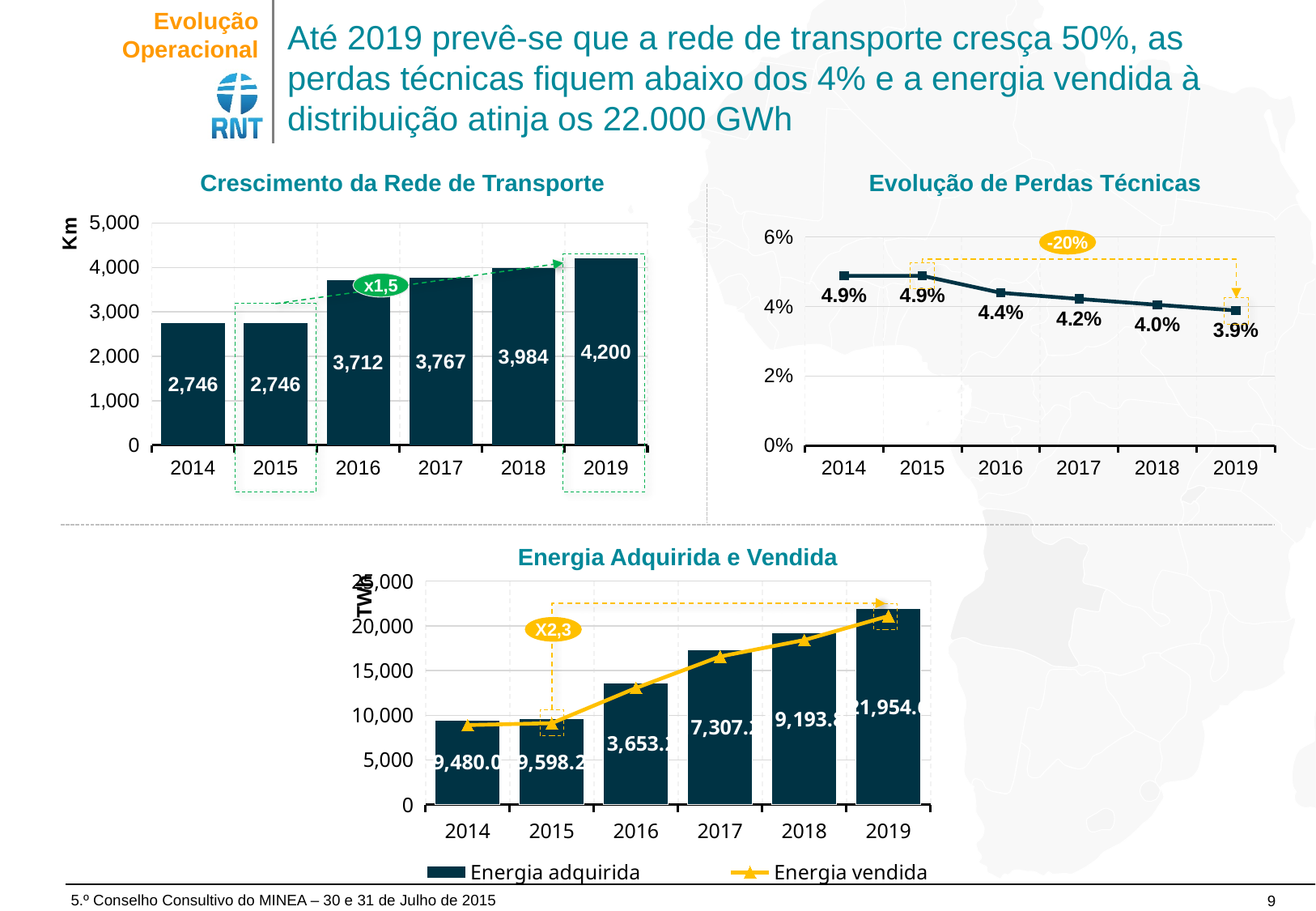
In the 'Crescimento da Rede de Transporte' chart, which is larger, the value for 2017 or 2018? 2018 In the 'Evolução de Perdas Técnicas' chart, which year has the lowest value? 2019 In the 'Crescimento da Rede de Transporte' chart, what is the value for 2019? 4,200 In the 'Energia Adquirida e Vendida' chart, is the 'Energia adquirida' bar for 2019 greater or less than 20,000? greater How many bars are plotted in the 'Crescimento da Rede de Transporte' chart? 6 In the 'Evolução de Perdas Técnicas' chart, what is the value for 2017? 4.2% In the 'Crescimento da Rede de Transporte' chart, what is the difference between the 2019 and 2014 values? 1,454 In the 'Crescimento da Rede de Transporte' chart, which year has the highest value? 2019 In the 'Evolução de Perdas Técnicas' chart, do the values rise or fall from 2014 to 2019? fall In the 'Crescimento da Rede de Transporte' chart, what is the value for 2016? 3,712 How many series does the legend of the 'Energia Adquirida e Vendida' chart list? 2 What kind of chart is 'Crescimento da Rede de Transporte'? bar chart